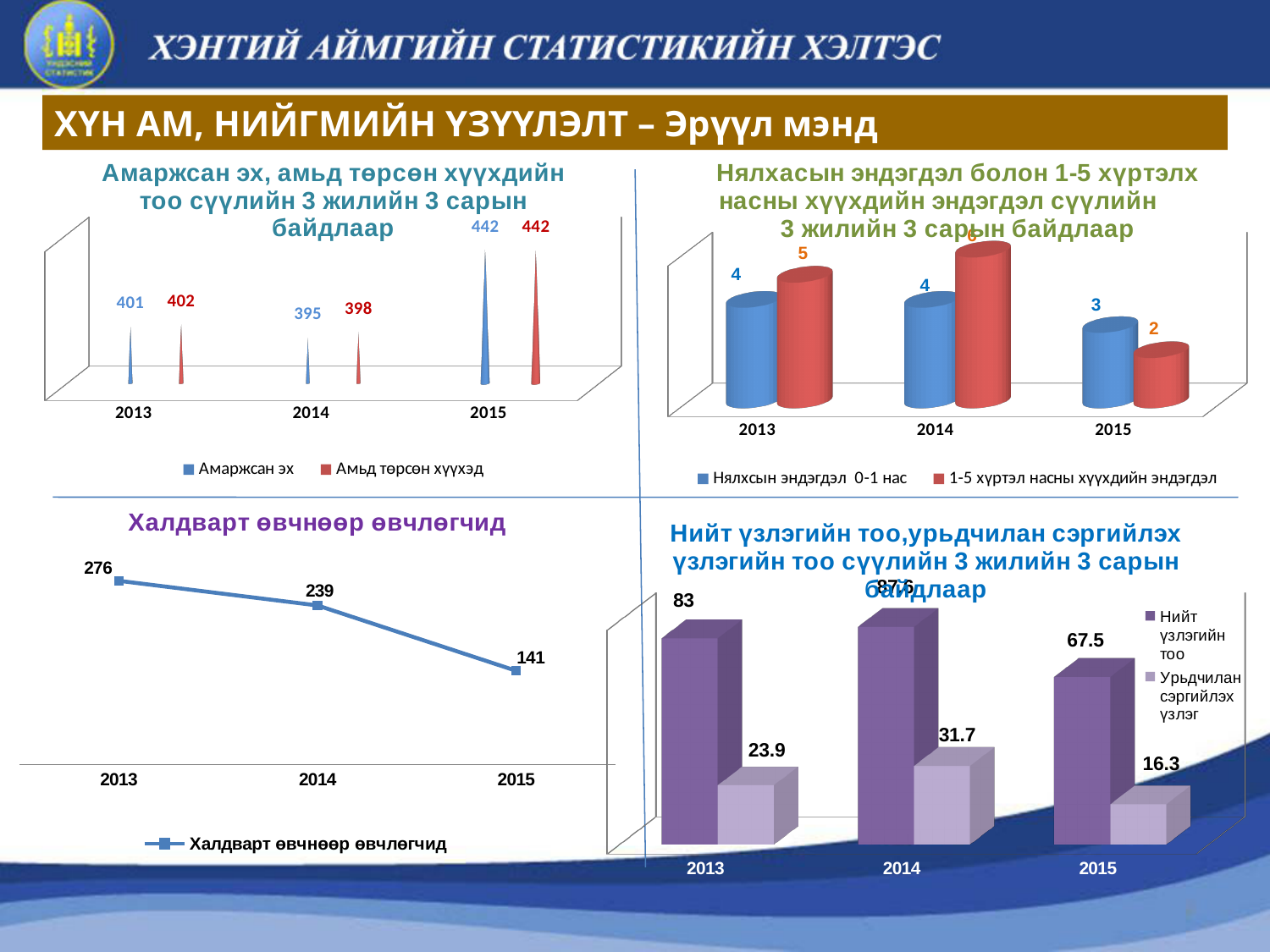
In the top-right chart (Нялхасын эндэгдэл), how many series does the legend list? 2 In the top-left chart (Амаржсан эх, амьд төрсөн хүүхдийн тоо), what is the value for Амаржсан эх in 2013? 401 In the bottom-left chart (Халдварт өвчнөөр өвчлөгчид), do the values rise or fall from 2013 to 2015? Fall In the top-right chart (Нялхасын эндэгдэл), which is larger in 2015: Нялхсын эндэгдэл 0-1 нас or 1-5 хүртэл насны хүүхдийн эндэгдэл? Нялхсын эндэгдэл 0-1 нас In the bottom-right chart (Нийт үзлэгийн тоо), what is the value for Урьдчилан сэргийлэх үзлэг in 2014? 31.7 In the bottom-right chart (Нийт үзлэгийн тоо), in which year is the Урьдчилан сэргийлэх үзлэг value lowest? 2015 In the top-left chart (Амаржсан эх, амьд төрсөн хүүхдийн тоо), what is the value for Амьд төрсөн хүүхэд in 2014? 398 What kind of chart is the bottom-left chart (Халдварт өвчнөөр өвчлөгчид)? Line chart In the top-left chart (Амаржсан эх, амьд төрсөн хүүхдийн тоо), in which year is the Амаржсан эх value highest? 2015 In the top-right chart (Нялхасын эндэгдэл), what is the value for 1-5 хүртэл насны хүүхдийн эндэгдэл in 2014? 6 In the top-left chart (Амаржсан эх, амьд төрсөн хүүхдийн тоо), what is the difference between the Амьд төрсөн хүүхэд values for 2015 and 2014? 44 In the bottom-left chart (Халдварт өвчнөөр өвчлөгчид), what is the difference between the 2013 and 2015 values? 135